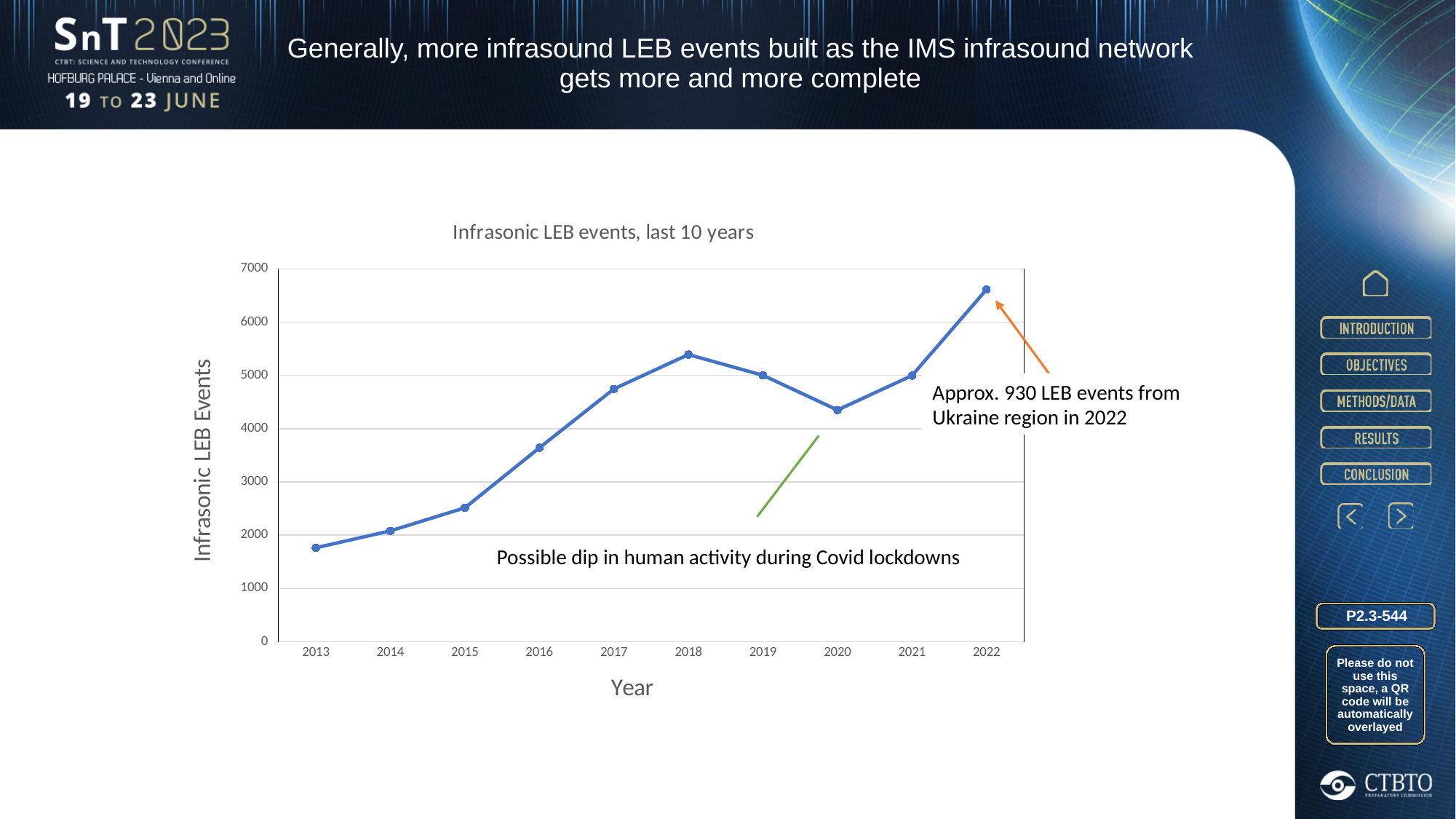
Which year has the highest number of infrasonic LEB events? 2022 Which year has the lowest number of infrasonic LEB events? 2013 Is the value for 2022 greater or less than 6000? greater How many years are plotted on the x axis of the chart? 10 Is the value for 2016 greater or less than 3000? greater Do the values rise or fall from 2013 to 2018? rise What is the title of the chart? Infrasonic LEB events, last 10 years Is the value for 2013 greater or less than 2000? less What kind of chart is shown on the slide? line chart What is the label of the y axis? Infrasonic LEB Events Which year has more infrasonic LEB events, 2018 or 2020? 2018